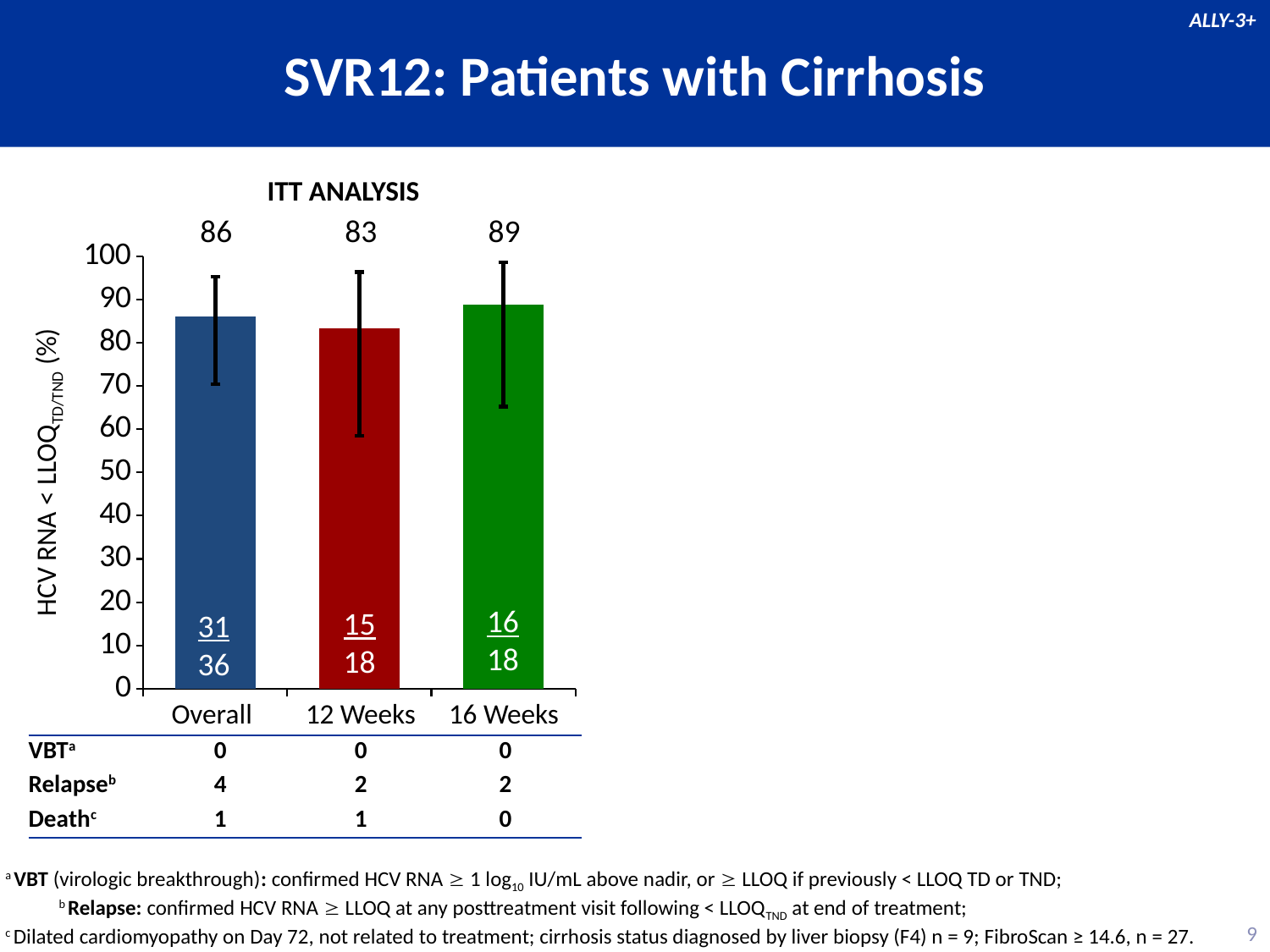
Is the SVR12 value for the 12 Weeks group greater or less than 80? greater Which group has the highest SVR12 value? 16 Weeks What is the SVR12 value (%) for the 12 Weeks group? 83 Which group has a higher SVR12 value, Overall or 12 Weeks? Overall What kind of chart is shown on the slide? bar chart Which group has the lowest SVR12 value? 12 Weeks What is the difference in SVR12 (%) between the 16 Weeks and 12 Weeks groups? 6 What fraction of patients is shown inside the Overall bar? 31/36 What is the label shown above the chart? ITT ANALYSIS How many groups are shown on the x axis of the chart? 3 What is the SVR12 value (%) for the Overall group? 86 What is the SVR12 value (%) for the 16 Weeks group? 89